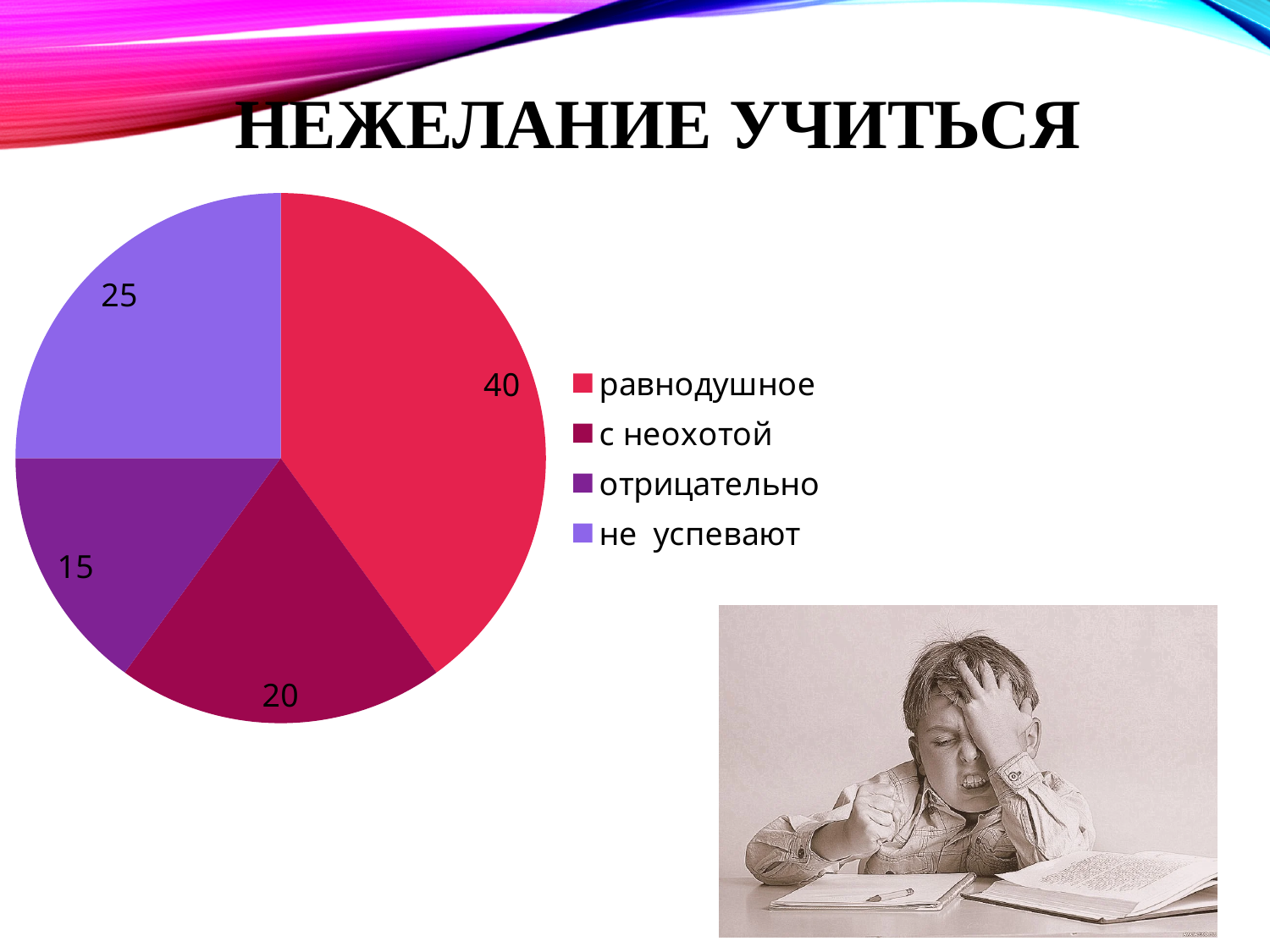
Which category has the smallest slice? отрицательно What kind of chart is shown on the slide? pie chart What is the value for с неохотой? 20 What is the difference between the values for равнодушное and не успевают? 15 What is the value for отрицательно? 15 What is the value for не успевают? 25 What is the value for равнодушное? 40 Which is larger, the value for с неохотой or the value for не успевают? не успевают What share of the pie does the равнодушное slice represent? 40% What is the title of the slide containing the chart? НЕЖЕЛАНИЕ УЧИТЬСЯ Which category has the largest slice? равнодушное How many slices does the pie chart have? 4